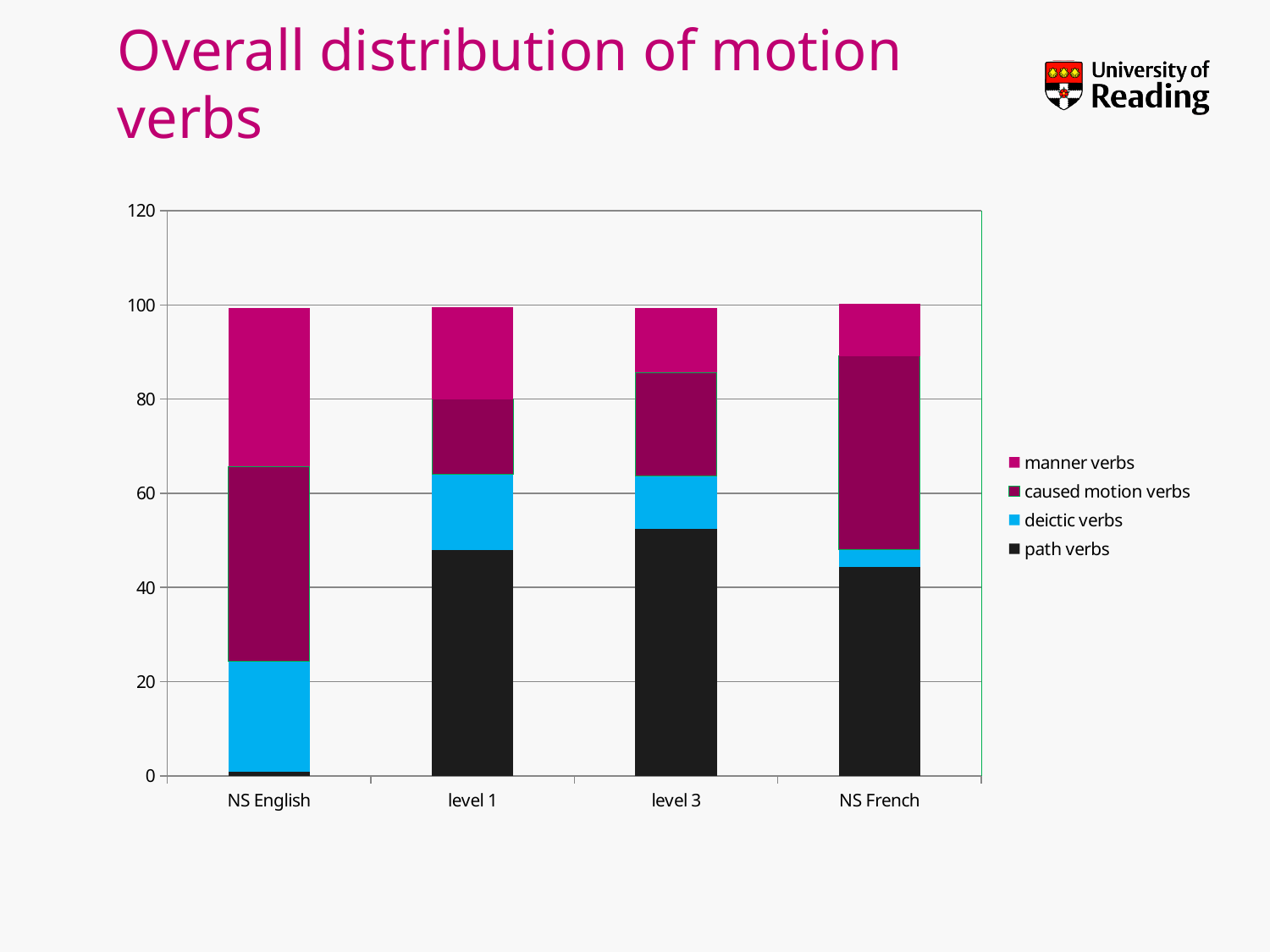
Is the path verbs value for NS English greater or less than 20? less Which category has the smallest deictic verbs segment? NS French Which category has the largest manner verbs segment? NS English What kind of chart is shown on the slide? stacked bar chart Which is larger, the deictic verbs segment for NS English or for NS French? NS English Which series is shown in black? path verbs Is the path verbs value for level 3 greater or less than 40? greater Is the manner verbs value for NS English greater or less than 20? greater Which is larger, the path verbs segment for NS English or for level 1? level 1 Which category has the smallest path verbs segment? NS English How many categories are shown on the x axis? 4 How many series does the legend list? 4